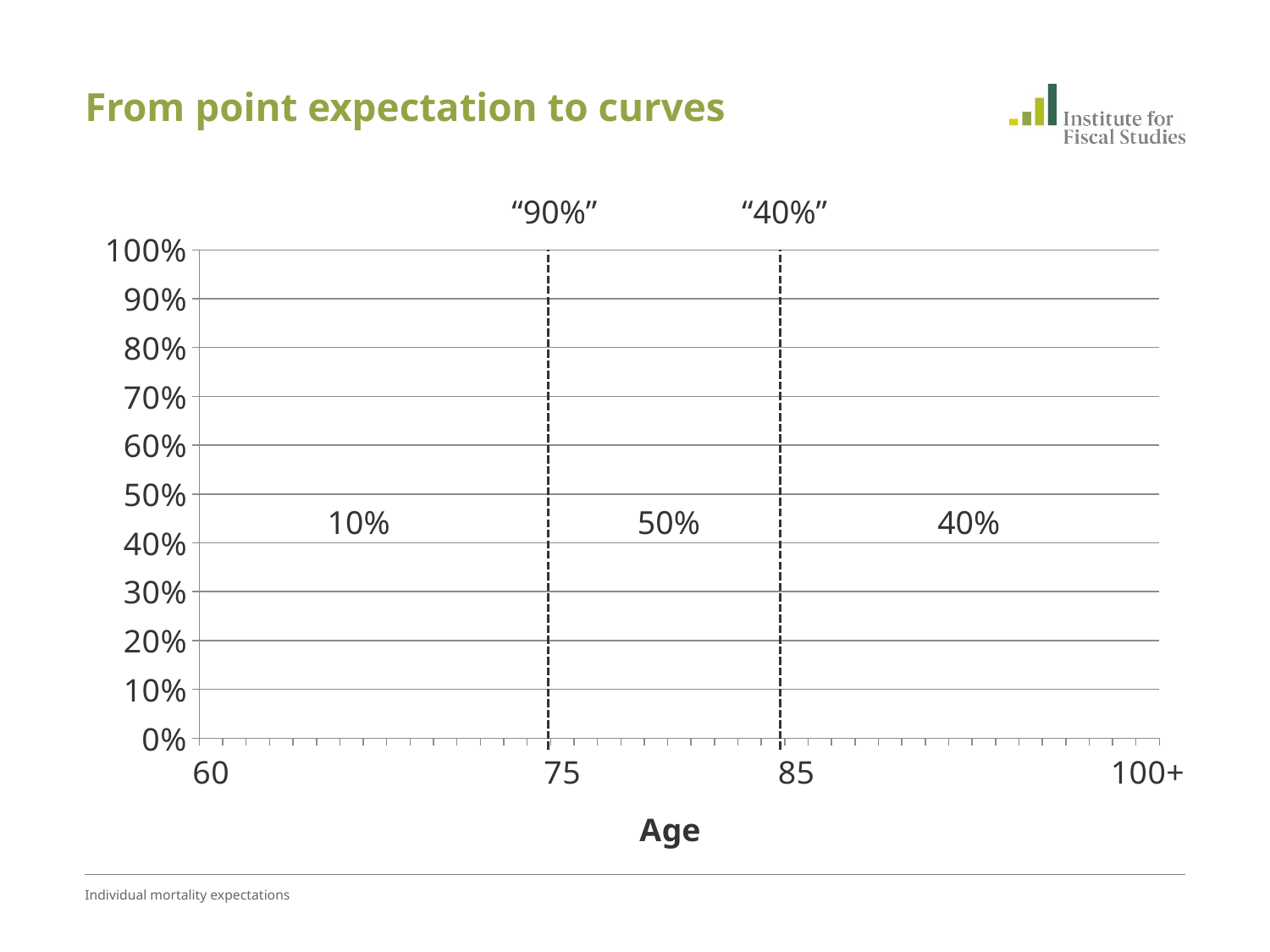
What is the difference between the percentage printed for ages 75 to 85 and the percentage printed for ages 60 to 75? 40% What percentage is printed in the region between ages 75 and 85? 50% Which is larger: the percentage printed for ages 75 to 85 or the percentage printed for ages 85 to 100+? 75 to 85 What percentage is printed in the region between ages 60 and 75? 10% What quoted value is printed above the dashed line at age 75? “90%” Which age region has the lowest printed percentage? 60 to 75 What is the label on the x axis of the chart? Age What percentage is printed in the region between ages 85 and 100+? 40% What quoted value is printed above the dashed line at age 85? “40%” What is the title of the chart slide? From point expectation to curves Which age region has the highest printed percentage? 75 to 85 What is the total of the three percentages printed in the age regions? 100%